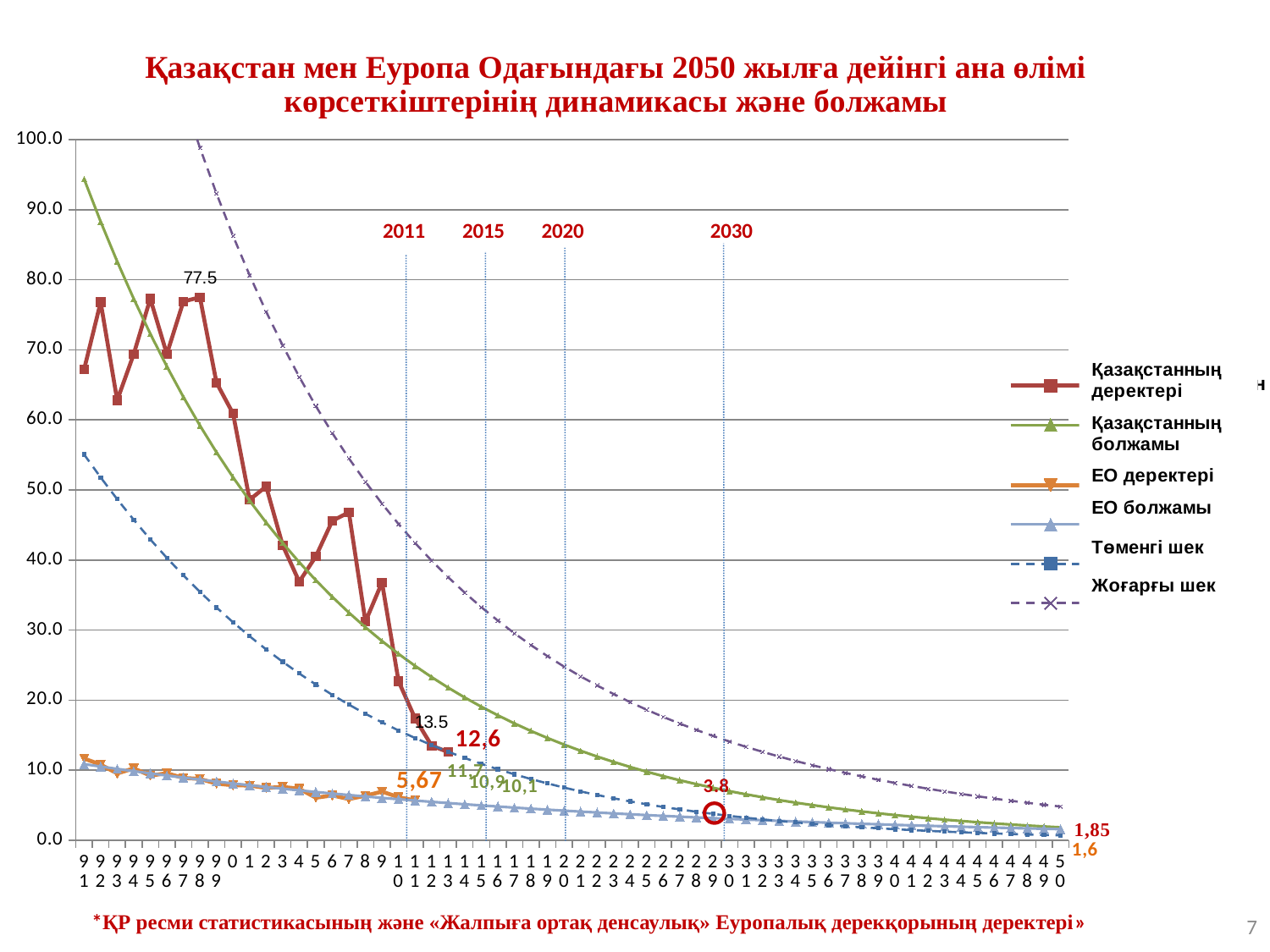
What value is labelled inside the red circle at the 2030 marker? 3,8 Does the Қазақстанның болжамы series rise or fall along the x axis? falls What orange value is labelled at the right end of the chart (2050)? 1,6 What red value is labelled at the right end of the chart (2050)? 1,85 Which legend entry is drawn as a purple dashed line with x markers? Жоғарғы шек How many series does the legend list? 6 Is the first value of the Қазақстанның деректері series (1991) greater or less than 60? greater What is the highest labelled value on the Қазақстанның деректері series? 77.5 Which labelled value is larger, the red 12,6 or the orange 5,67? 12,6 Is the first value of the ЕО деректері series (1991) greater or less than 20? less What is the difference between the labelled values 77.5 and 13.5 on the Қазақстанның деректері series? 64 What kind of chart is shown on the slide? line chart